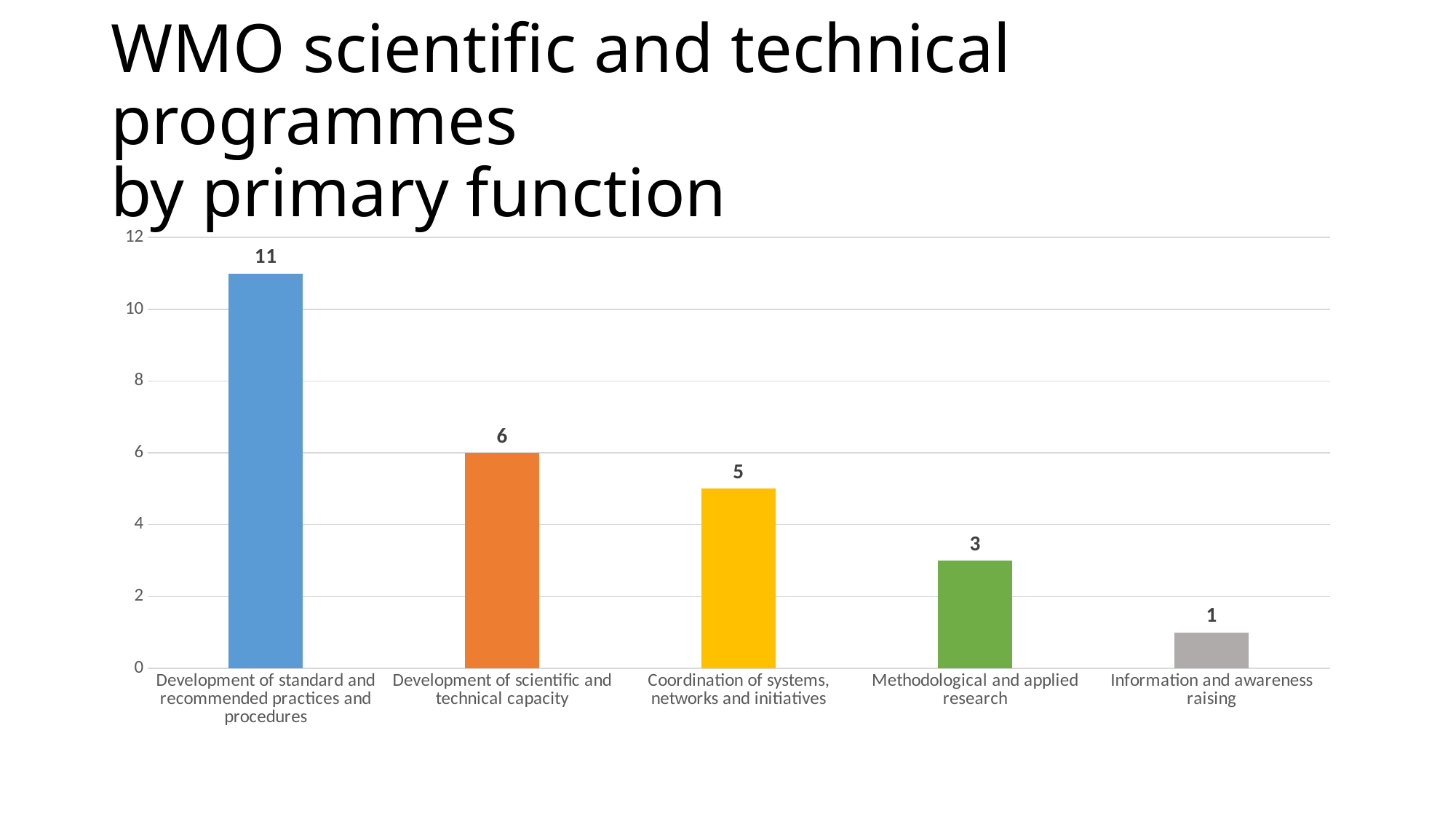
Do the values rise or fall from left to right across the categories? fall Is the value for Development of scientific and technical capacity greater or less than 4? greater Which category has the lowest value? Information and awareness raising What is the difference between the values for Development of standard and recommended practices and procedures and Development of scientific and technical capacity? 5 What kind of chart is shown on the slide? bar chart What colour is the bar for Methodological and applied research? green Which is larger: the value for Methodological and applied research or the value for Coordination of systems, networks and initiatives? Coordination of systems, networks and initiatives Which category has the highest value? Development of standard and recommended practices and procedures What is the value for Coordination of systems, networks and initiatives? 5 What is the value for Development of standard and recommended practices and procedures? 11 How many categories are shown in the chart? 5 What is the value for Information and awareness raising? 1